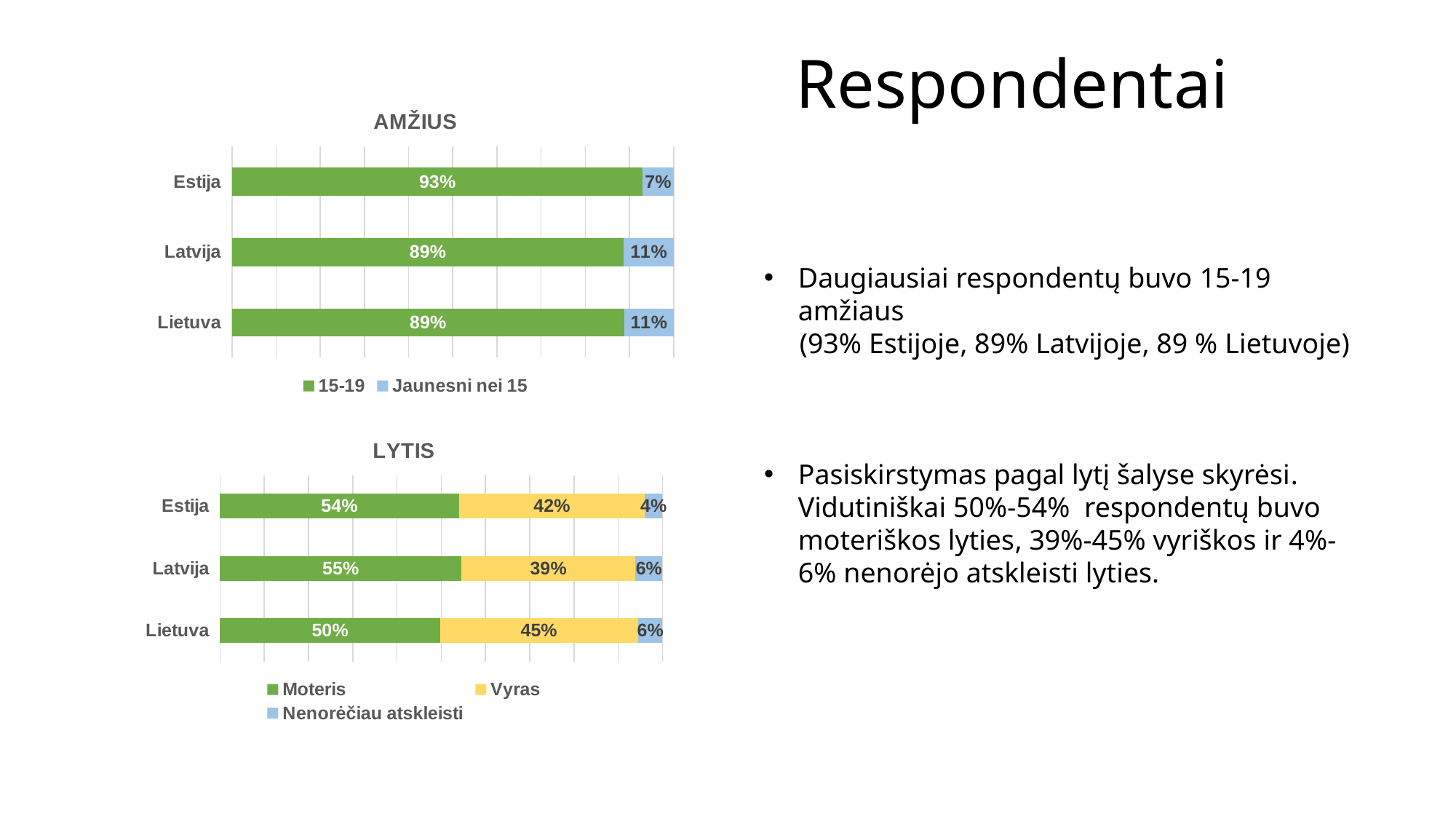
In the LYTIS chart, what is the value for Vyras in Lietuva? 45% In the AMŽIUS chart, how many series does the legend list? 2 In the LYTIS chart, what is the value for Nenorėčiau atskleisti in Estija? 4% In the LYTIS chart, how many countries are shown? 3 In the LYTIS chart, how many series does the legend list? 3 What kind of chart is the LYTIS chart? Stacked bar chart In the AMŽIUS chart, what is the value for 15-19 in Estija? 93% In the AMŽIUS chart, what is the value for Jaunesni nei 15 in Latvija? 11% In the AMŽIUS chart, what is the difference between the 15-19 value for Estija and for Lietuva? 4% In the LYTIS chart, is the Moteris value for Latvija larger or the Vyras value for Latvija? Moteris In the LYTIS chart, which country has the lowest value for Moteris? Lietuva In the AMŽIUS chart, which country has the highest value for 15-19? Estija